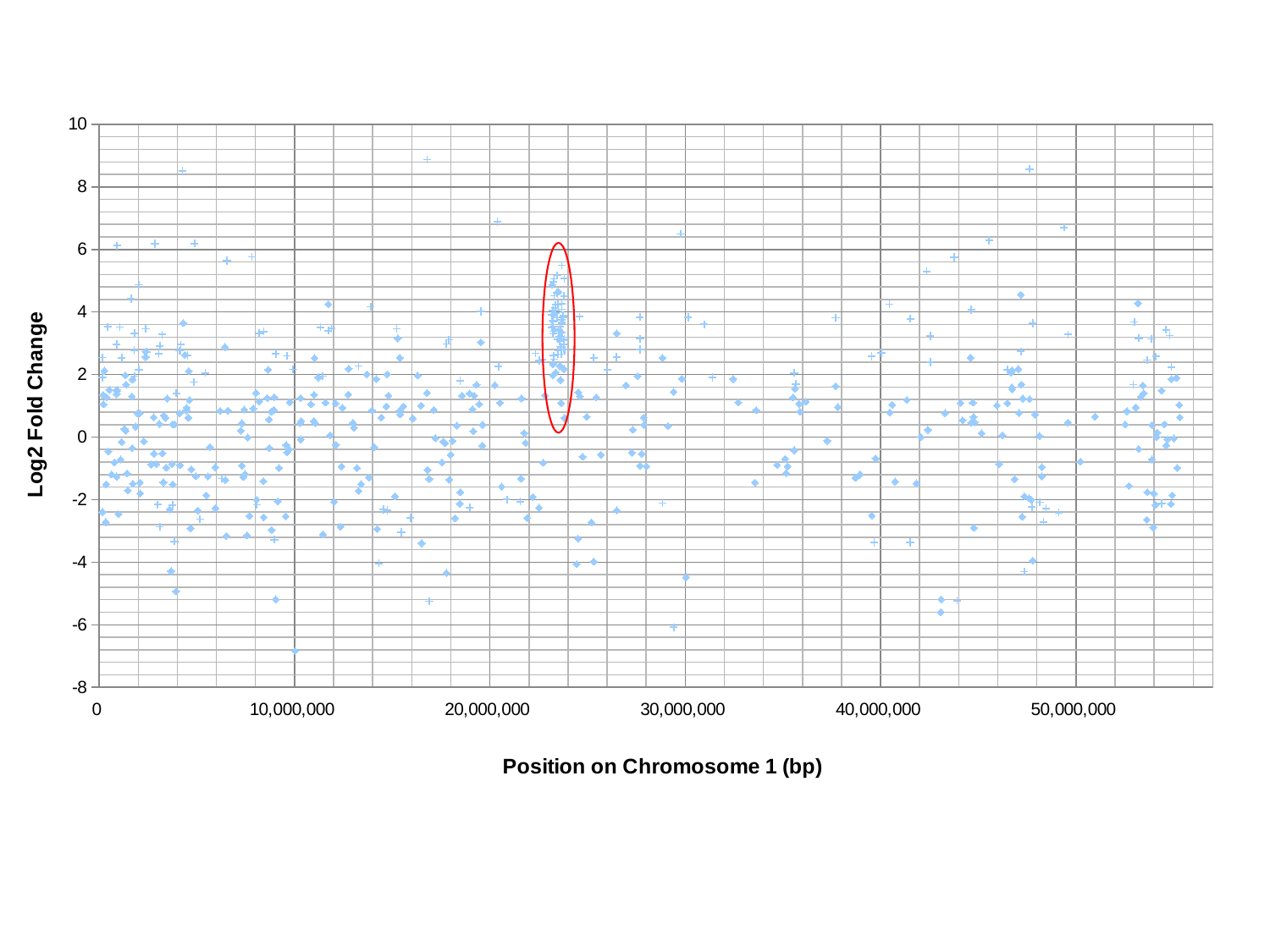
What is the title of the horizontal axis? Position on Chromosome 1 (bp) Is the lowest plotted Log2 Fold Change value greater or less than -6? less Is the highest plotted Log2 Fold Change value greater or less than 8? greater What kind of chart is shown on the slide? scatter chart What is the title of the vertical axis? Log2 Fold Change Are the points inside the red ellipse plotted at Log2 Fold Change values greater or less than 0? greater